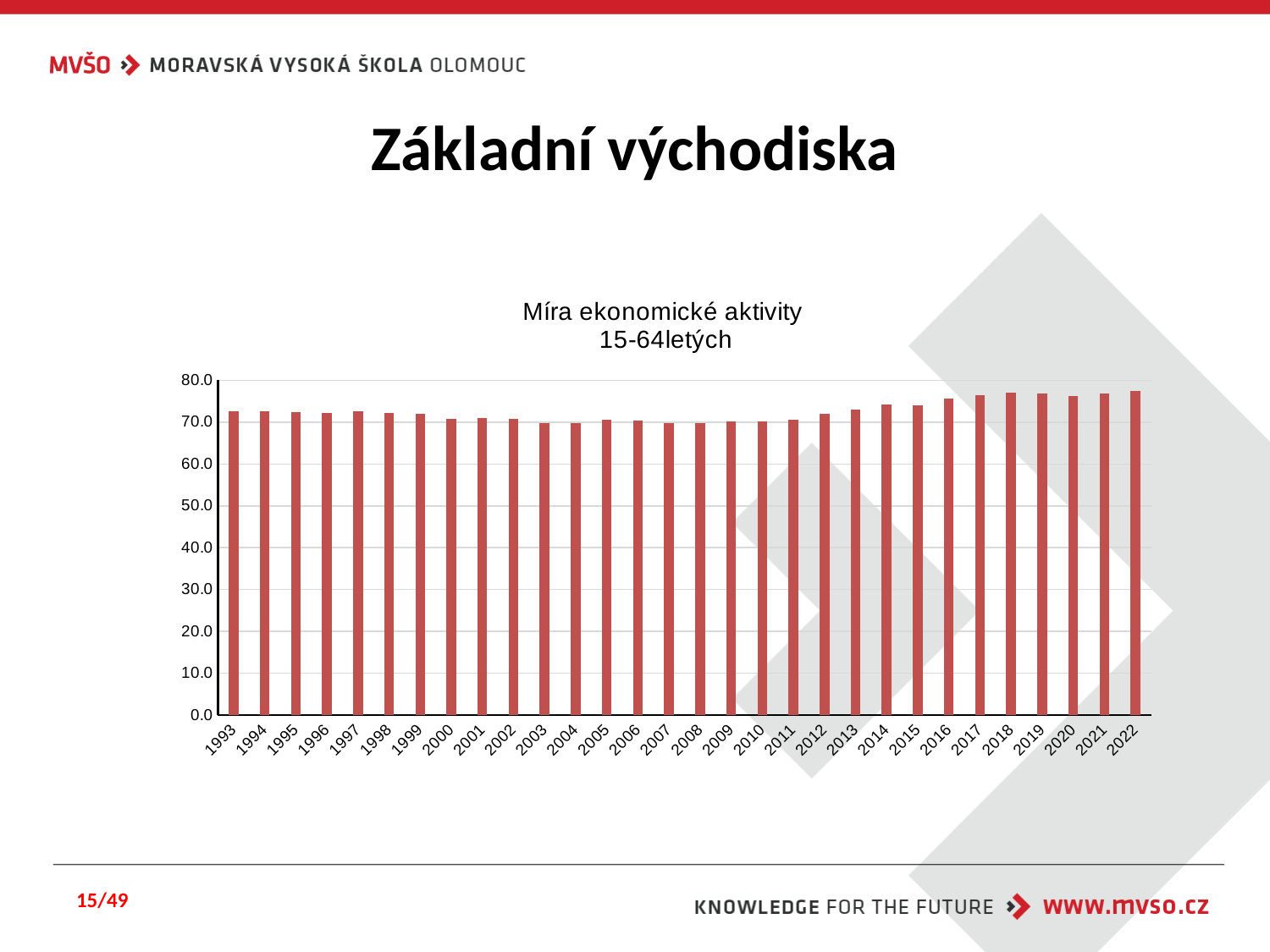
Do the values rise or fall from 1993 to 2004? fall Which is larger, the value for 2010 or the value for 2017? 2017 What kind of chart is shown on the slide? bar chart Which is larger, the value for 2022 or the value for 1993? 2022 Is the value for 1993 greater or less than 80? less Is the value for 2022 greater or less than 70? greater What is the title of the chart? Míra ekonomické aktivity 15-64letých How many years (bars) are plotted on the chart? 30 Do the values rise or fall from 2013 to 2022? rise Is the value for 2010 greater or less than 80? less What is the first year shown on the x axis? 1993